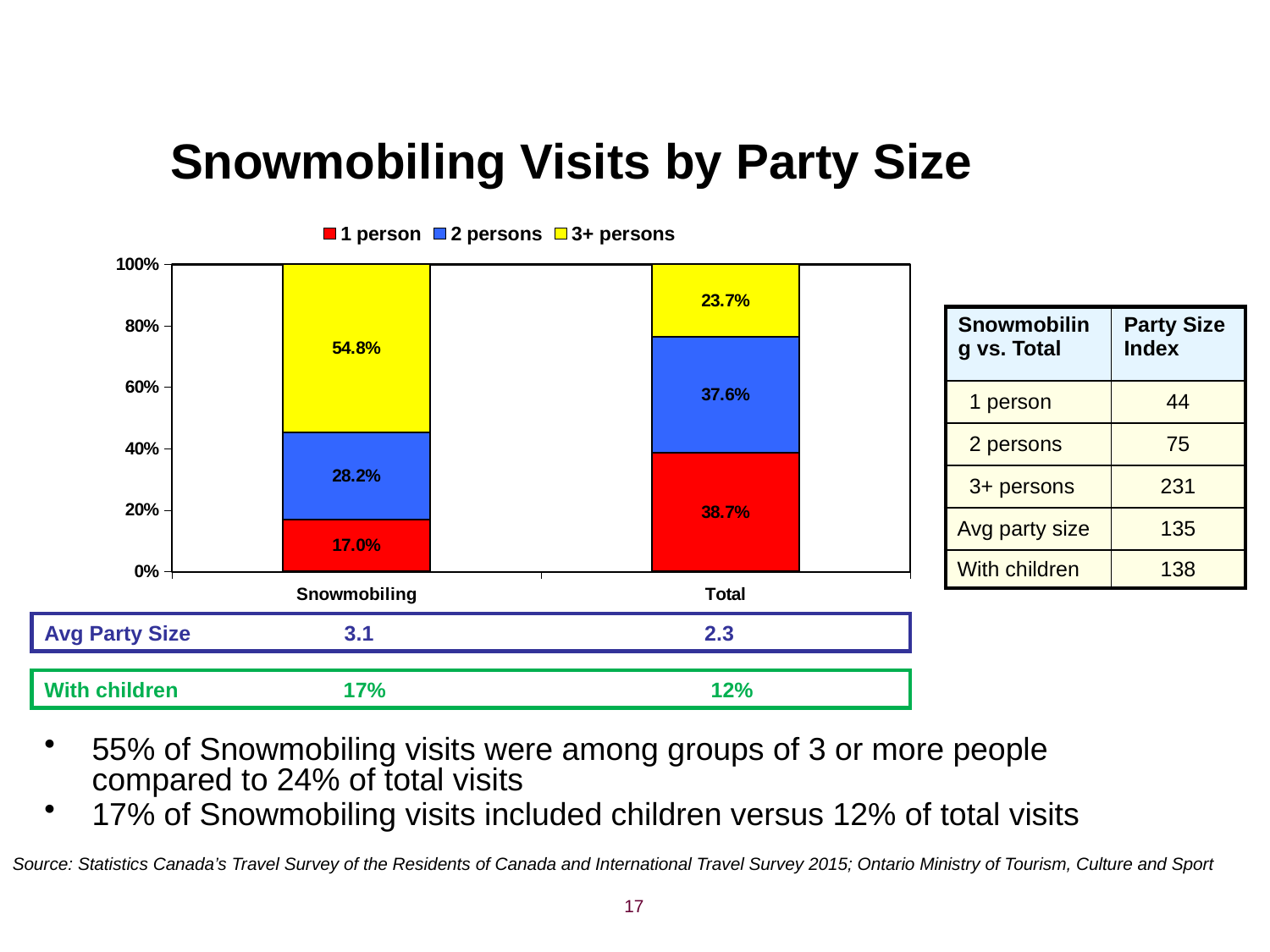
What type of chart is shown on the slide? Stacked bar chart Which party size segment is the smallest for Total? 3+ persons What percentage of Snowmobiling visits were 2 persons parties? 28.2% Which is larger: the 1 person share for Snowmobiling or for Total? Total How many series does the chart legend list? 3 How many categories are shown on the x axis of the chart? 2 What is the difference in percentage points between the 3+ persons share for Snowmobiling and for Total? 31.1 What percentage of Snowmobiling visits were 3+ persons parties? 54.8% What percentage of Total visits were 1 person parties? 38.7% Which colour represents the 2 persons series in the chart? Blue What percentage of Total visits were 2 persons parties? 37.6% Which party size segment is the largest for Snowmobiling? 3+ persons